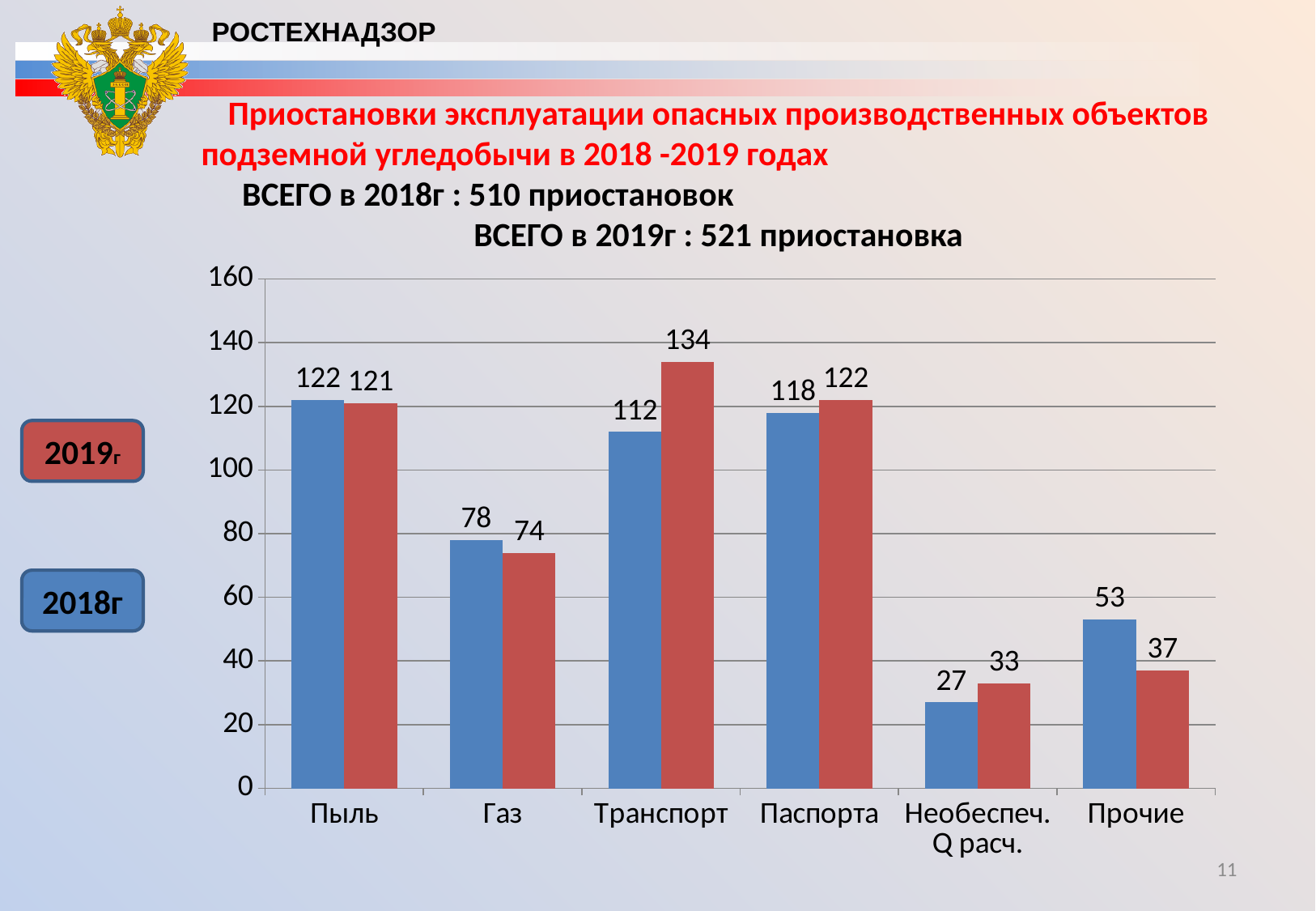
Which is larger for Прочие: the 2018 value or the 2019 value? 2018 Which category has the lowest value in 2018? Необеспеч. Q расч. What is the value for Прочие in 2019? 37 Which category has the highest value in 2019? Транспорт How many categories are shown on the x axis? 6 Which colour represents the year 2019? red What kind of chart is shown on the slide? bar chart What is the difference between the 2019 and 2018 values for Транспорт? 22 What is the value for Пыль in 2018? 122 How many series does the chart show? 2 What is the value for Транспорт in 2019? 134 Is the value for Паспорта in 2018 greater or less than 100? greater